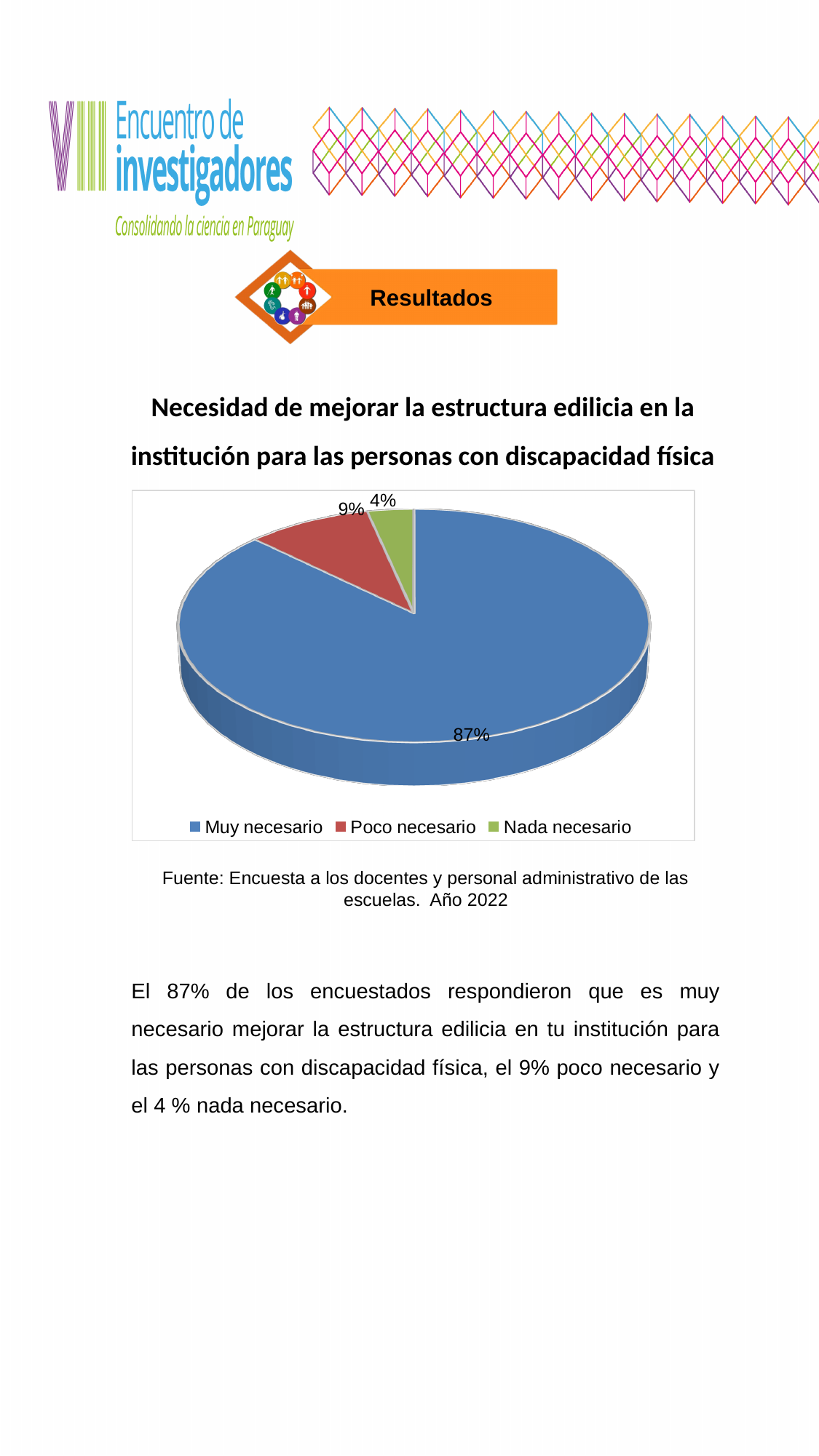
What percentage of respondents answered "Poco necesario"? 9% What kind of chart is shown on the slide? Pie chart What is the title of the chart? Necesidad de mejorar la estructura edilicia en la institución para las personas con discapacidad física What is the difference in percentage points between "Muy necesario" and "Poco necesario"? 78 Which category has the largest share of the pie? Muy necesario What is the difference in percentage points between "Poco necesario" and "Nada necesario"? 5 Which category has the smallest share of the pie? Nada necesario What percentage of respondents answered "Muy necesario"? 87% How many categories does the pie chart show? 3 What colour is the "Poco necesario" slice? Red What percentage of respondents answered "Nada necesario"? 4% Which is larger, the share for "Poco necesario" or the share for "Nada necesario"? Poco necesario